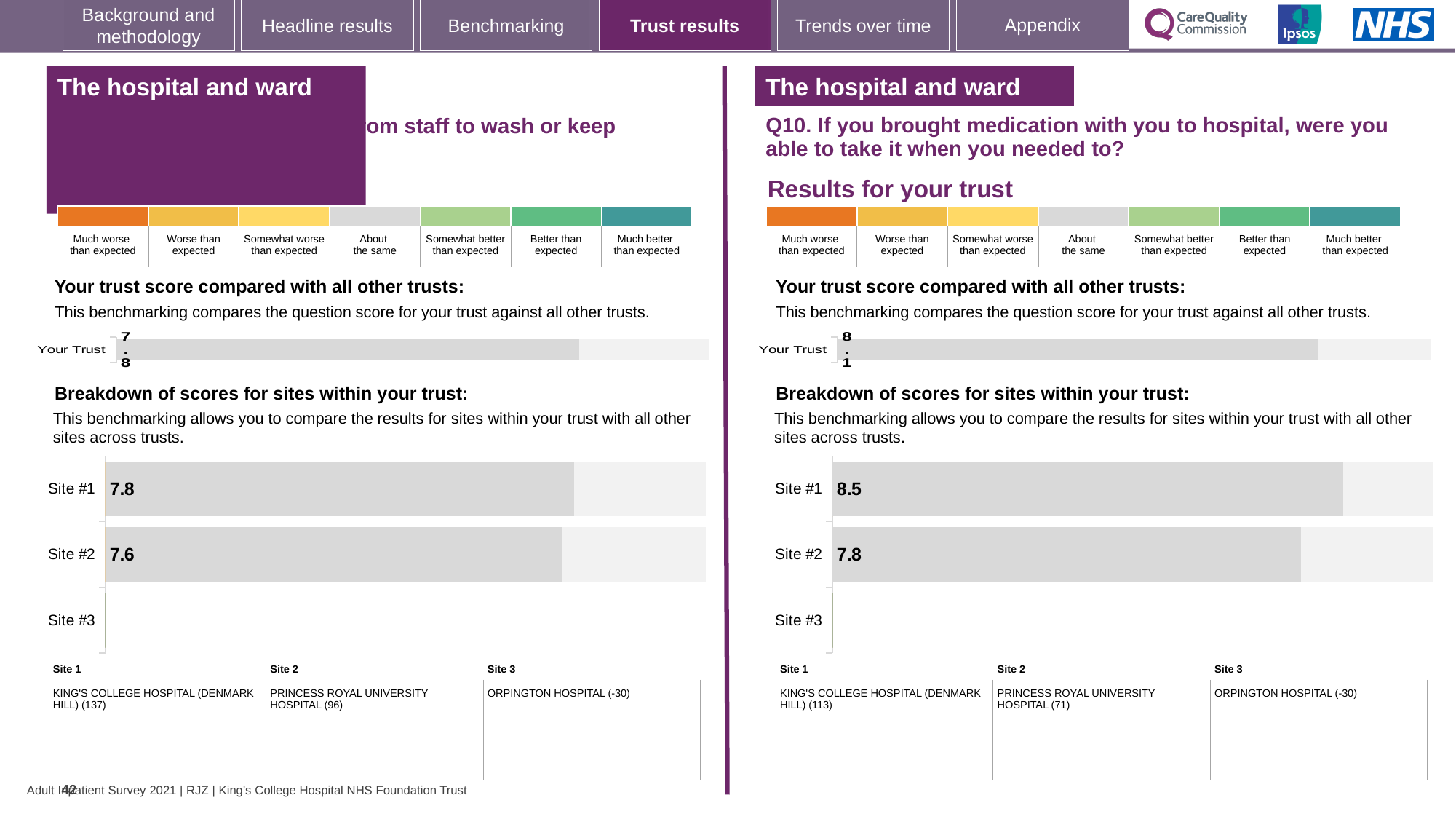
In the right-hand panel (Q10) site breakdown chart, what is the score for Site #1? 8.5 In the left-hand panel site breakdown chart, what is the score for Site #2? 7.6 In the right-hand panel (Q10) site breakdown chart, what is the score for Site #2? 7.8 In the left-hand panel site breakdown chart, which site has the higher score, Site #1 or Site #2? Site #1 In the right-hand panel (Q10) site breakdown chart, what is the difference between the Site #1 and Site #2 scores? 0.7 In the right-hand panel (Q10), what is the score shown for Your Trust? 8.1 In the left-hand panel site breakdown chart, what is the score for Site #1? 7.8 How many site categories are listed in the right-hand panel (Q10) site breakdown chart? 3 In the left-hand panel, what is the score shown for Your Trust? 7.8 In the right-hand panel (Q10) site breakdown chart, which site has the highest score? Site #1 In the left-hand panel site breakdown chart, what is the difference between the Site #1 and Site #2 scores? 0.2 What type of chart is used for the site breakdown in the right-hand panel (Q10)? Bar chart